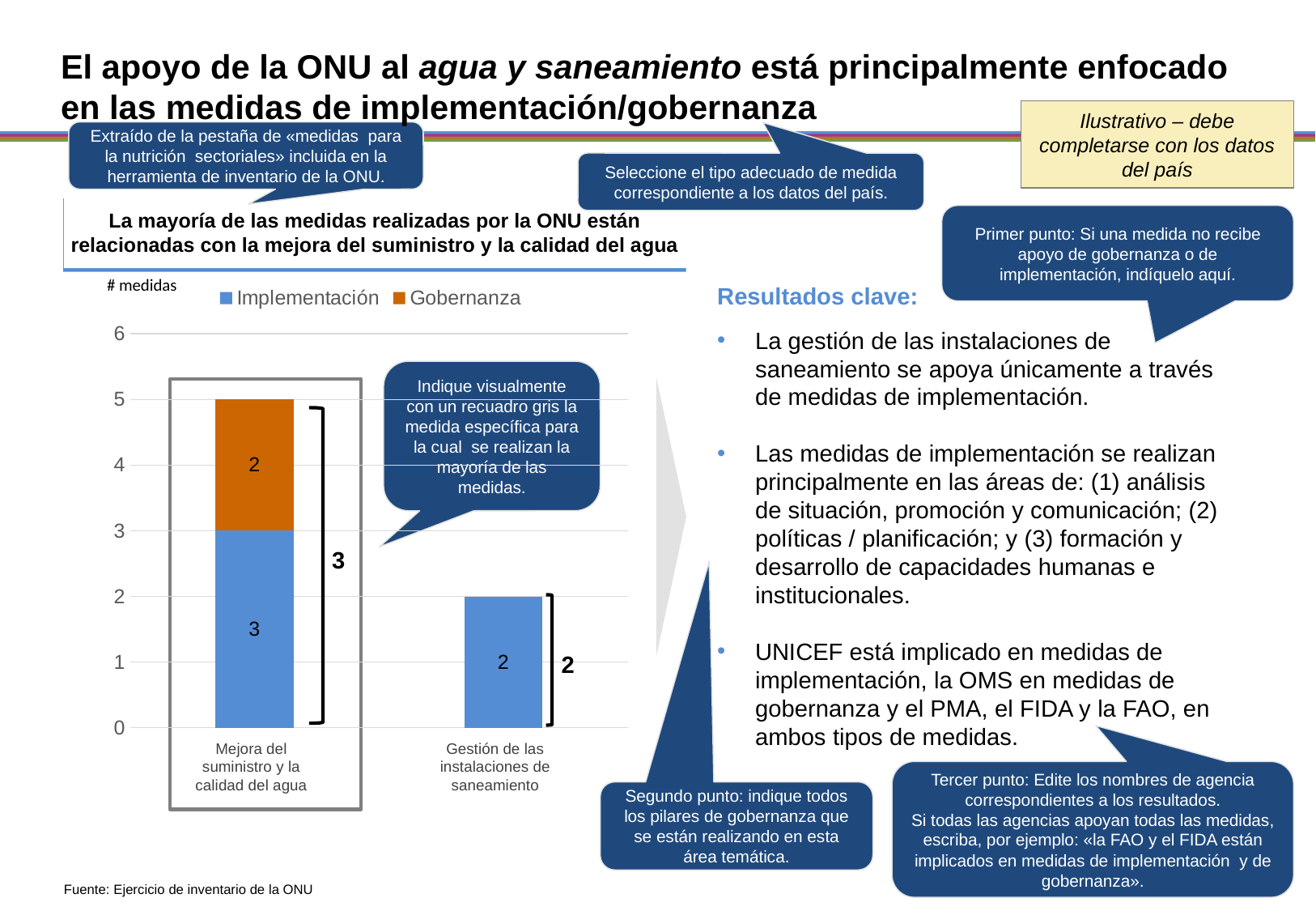
Is the Implementación value for 'Mejora del suministro y la calidad del agua' larger or smaller than its Gobernanza value? Larger Which two series are listed in the chart legend? Implementación and Gobernanza How many categories are shown on the x axis of the chart? 2 What kind of chart is shown on the slide? Stacked bar chart What is the difference between the Implementación values for 'Mejora del suministro y la calidad del agua' and 'Gestión de las instalaciones de saneamiento'? 1 Which category has the taller stacked bar? Mejora del suministro y la calidad del agua What is the Implementación value for 'Mejora del suministro y la calidad del agua'? 3 What is the total of the stacked bar for 'Mejora del suministro y la calidad del agua'? 5 What is the Gobernanza value for 'Mejora del suministro y la calidad del agua'? 2 What is the Implementación value for 'Gestión de las instalaciones de saneamiento'? 2 What label is shown on the vertical axis of the chart? # medidas How many series does the chart legend list? 2